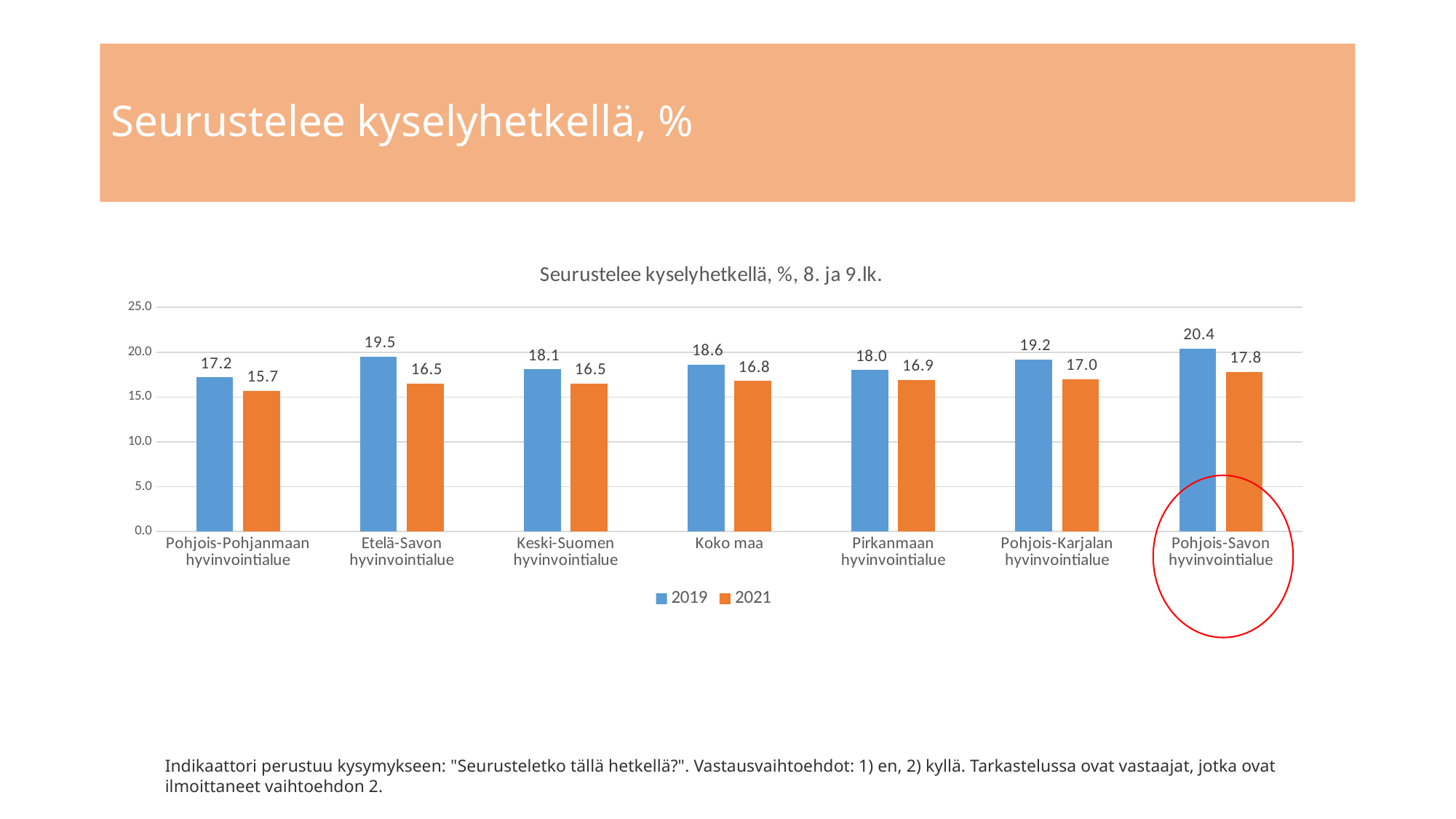
What kind of chart is shown on the slide? Bar chart What is the 2021 value for Koko maa? 16.8 Which category has the highest 2019 value? Pohjois-Savon hyvinvointialue How many categories are shown on the x axis? 7 Which category is circled in red on the chart? Pohjois-Savon hyvinvointialue How many series does the legend list? 2 What is the 2021 value for Pohjois-Pohjanmaan hyvinvointialue? 15.7 What is the 2019 value for Pohjois-Savon hyvinvointialue? 20.4 Which is larger for Pirkanmaan hyvinvointialue, the 2019 value or the 2021 value? 2019 What is the title of the chart? Seurustelee kyselyhetkellä, %, 8. ja 9.lk. What is the difference between the 2019 and 2021 values for Etelä-Savon hyvinvointialue? 3.0 Which category has the lowest 2021 value? Pohjois-Pohjanmaan hyvinvointialue